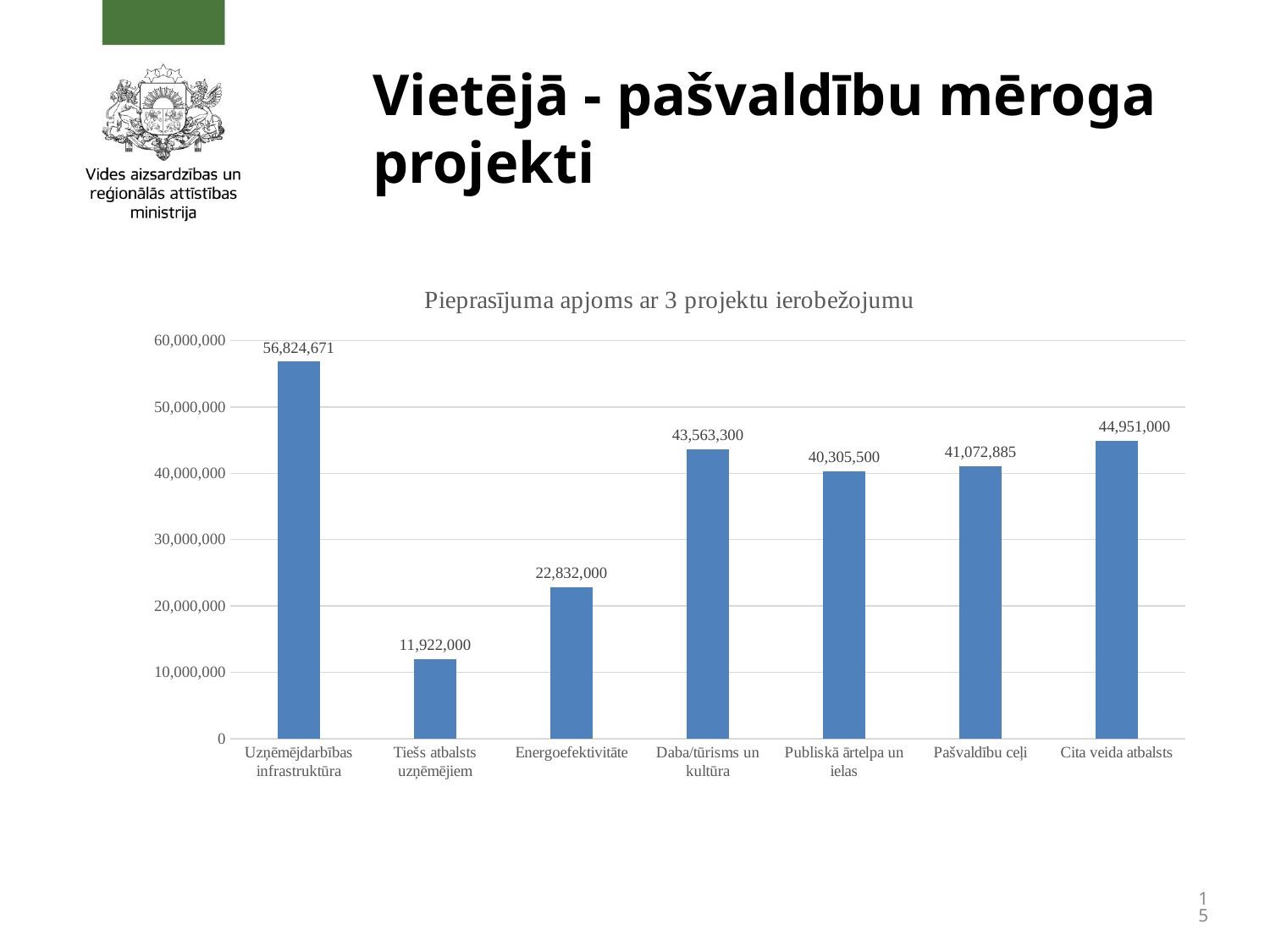
Is the value for Energoefektivitāte greater or less than 20,000,000? greater How many categories are shown on the x axis? 7 Which is larger, the value for Energoefektivitāte or the value for Tiešs atbalsts uzņēmējiem? Energoefektivitāte Which category has the lowest value? Tiešs atbalsts uzņēmējiem What is the value for Uzņēmējdarbības infrastruktūra? 56,824,671 What is the title of the chart? Pieprasījuma apjoms ar 3 projektu ierobežojumu Which category has the highest value? Uzņēmējdarbības infrastruktūra What is the difference between the values for Cita veida atbalsts and Daba/tūrisms un kultūra? 1,387,700 What is the difference between the values for Uzņēmējdarbības infrastruktūra and Tiešs atbalsts uzņēmējiem? 44,902,671 What is the value for Cita veida atbalsts? 44,951,000 What is the value for Pašvaldību ceļi? 41,072,885 What kind of chart is shown on the slide? bar chart